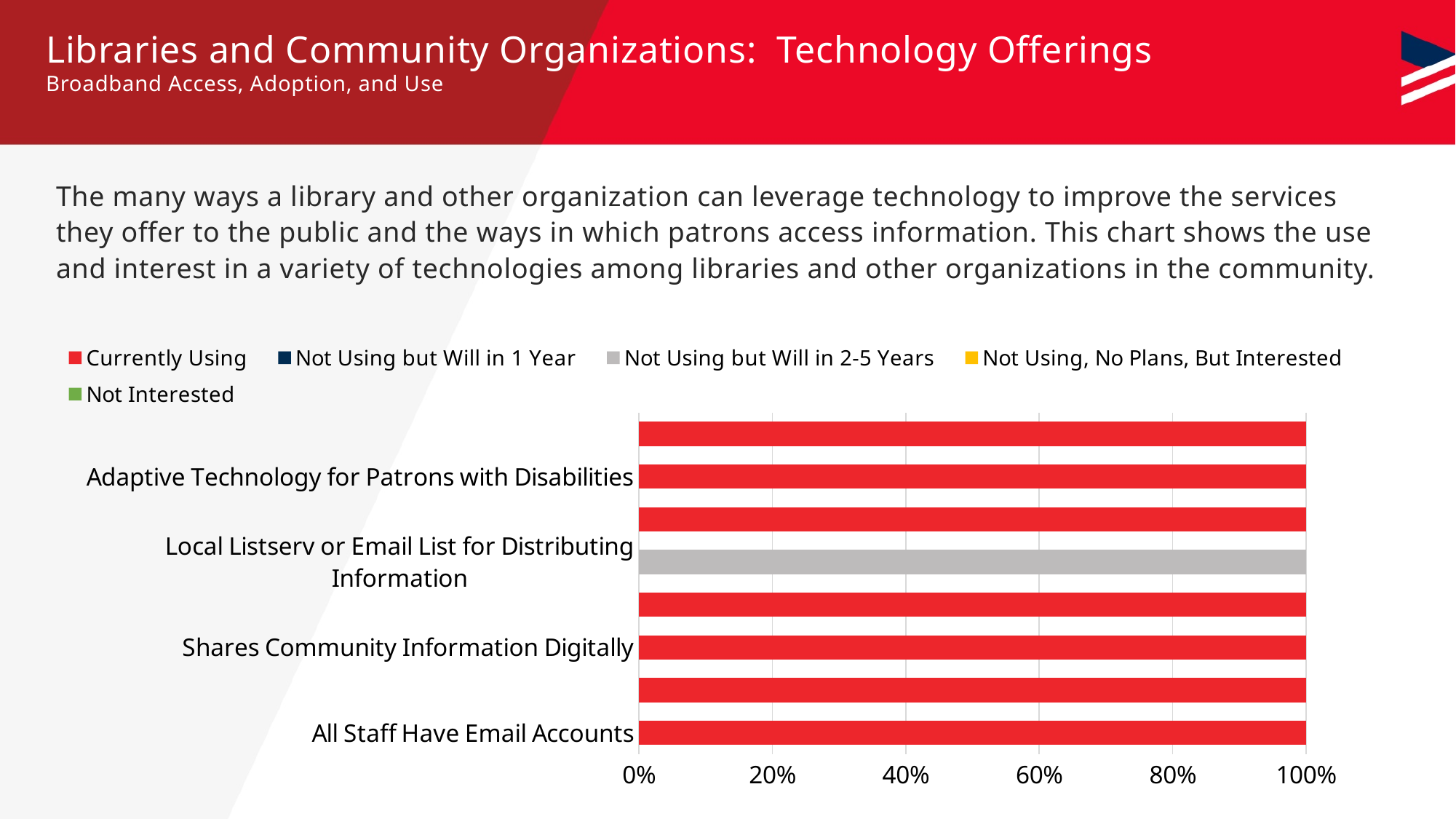
What is the value of the bar for Adaptive Technology for Patrons with Disabilities? 100% Is the value for Shares Community Information Digitally greater or less than 80%? greater Is the value for Adaptive Technology for Patrons with Disabilities greater or less than 40%? greater What kind of chart is shown on the slide? bar chart What is the value of the bar for Shares Community Information Digitally? 100% What is the value of the bar for All Staff Have Email Accounts? 100% What is the highest value shown on the x axis? 100% How many bars are plotted in the chart? 8 How many series does the chart legend list? 5 Which series does the bar for Local Listserv or Email List for Distributing Information belong to? Not Using but Will in 2-5 Years Which series does the bar for All Staff Have Email Accounts belong to? Currently Using Is the value for All Staff Have Email Accounts greater or less than 60%? greater